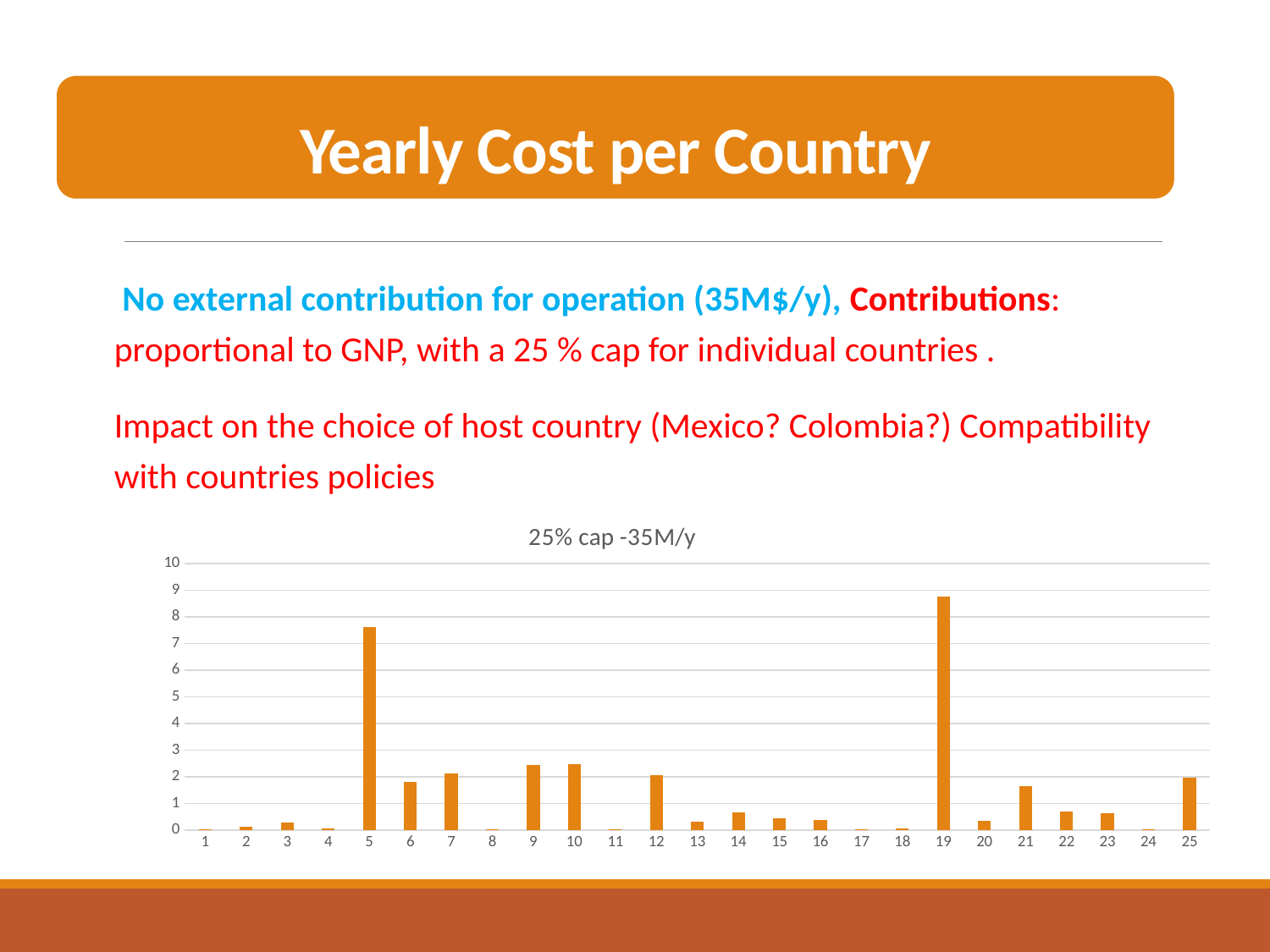
Is the value for category 5 greater or less than 7? greater Is the value for category 5 greater or less than 8? less Is the value for category 14 greater or less than 1? less How many categories are shown on the x axis of the chart? 25 Which has the larger value, category 9 or category 6? 9 What kind of chart is shown on the slide? bar chart What is the title of the chart? 25% cap -35M/y Which category has the highest bar in the chart? 19 Which has the larger value, category 19 or category 5? 19